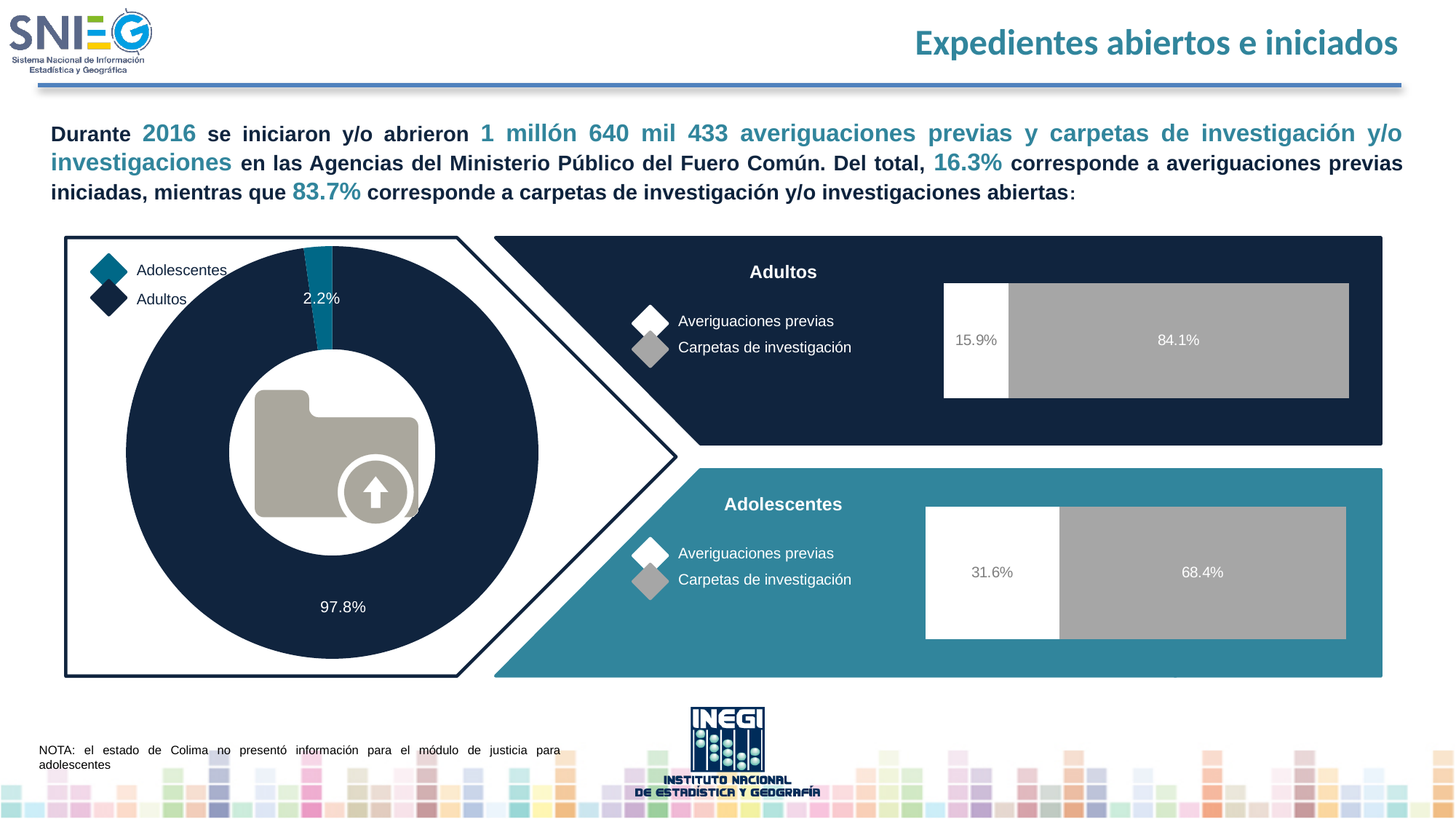
In the Adultos bar chart, what percentage corresponds to Carpetas de investigación? 84.1% In the donut chart on the left, which category has the larger share? Adultos In the Adultos bar chart, what is the difference between Carpetas de investigación and Averiguaciones previas? 68.2% What kind of chart is used on the left of the slide to show Adolescentes versus Adultos? Donut (pie) chart In the donut chart on the left, what share corresponds to Adolescentes? 2.2% In the donut chart on the left, what share corresponds to Adultos? 97.8% In the Adolescentes bar chart, what percentage corresponds to Carpetas de investigación? 68.4% In the Adultos bar chart, what percentage corresponds to Averiguaciones previas? 15.9% In the Adolescentes bar chart, what percentage corresponds to Averiguaciones previas? 31.6% Which group has the larger share of Averiguaciones previas, Adultos or Adolescentes? Adolescentes In the donut chart on the left, how many categories does the legend list? 2 In the Adolescentes bar chart, what is the difference between Carpetas de investigación and Averiguaciones previas? 36.8%